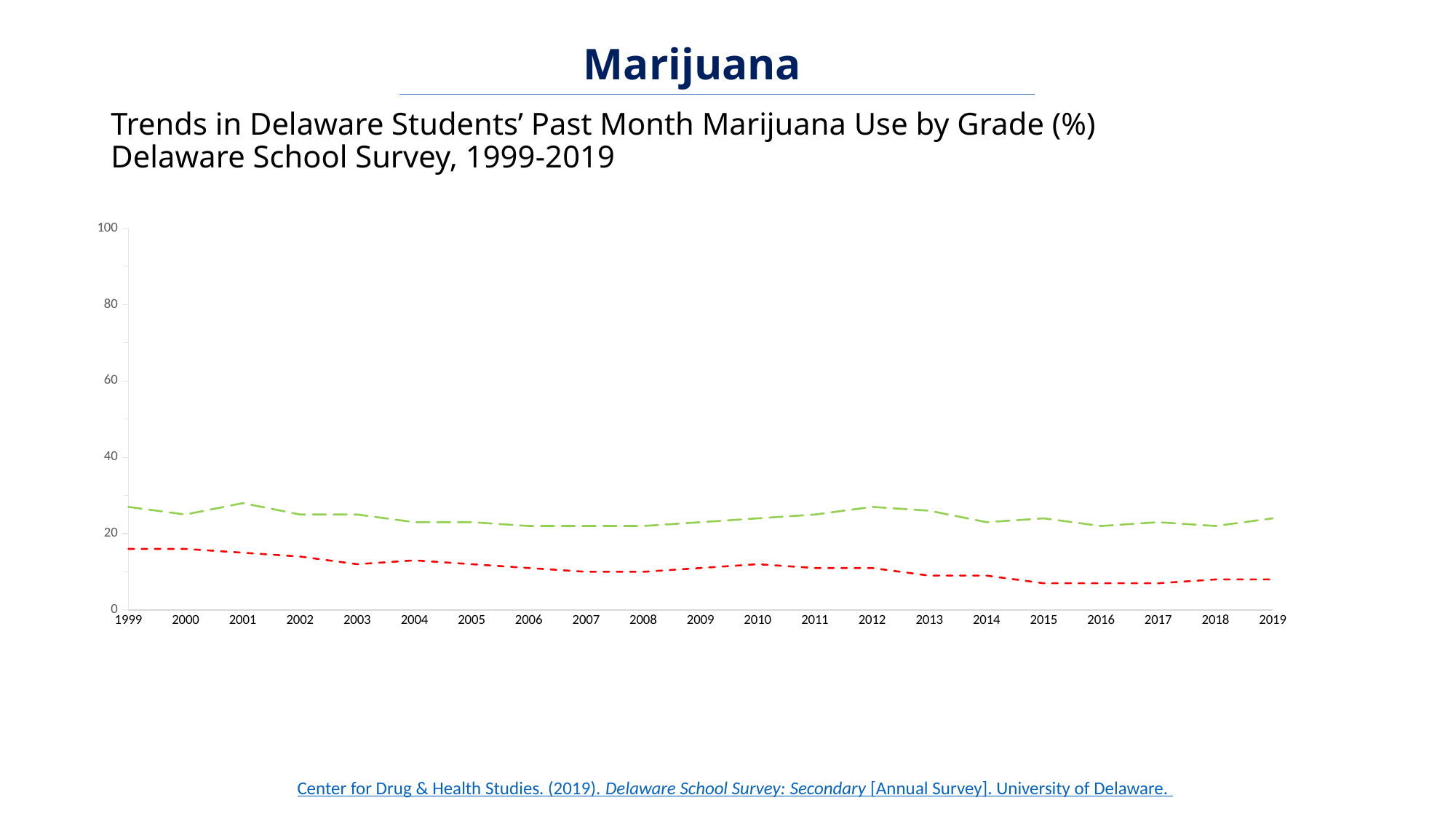
What kind of chart is shown on the slide? line chart Does the red dashed line rise or fall from 1999 to 2019? fall Is the value of the red dashed line in 1999 greater or less than 20? less Is the value of the red dashed line in 2019 greater or less than 20? less What is the highest value shown on the y axis? 100 Is the value of the green dashed line in 1999 greater or less than 20? greater What is the first year shown on the x axis? 1999 How many lines are plotted on the chart? 2 Which line is higher in 2010, the green dashed line or the red dashed line? the green dashed line How many years are plotted along the x axis? 21 Is the red dashed line higher in 1999 or in 2015? 1999